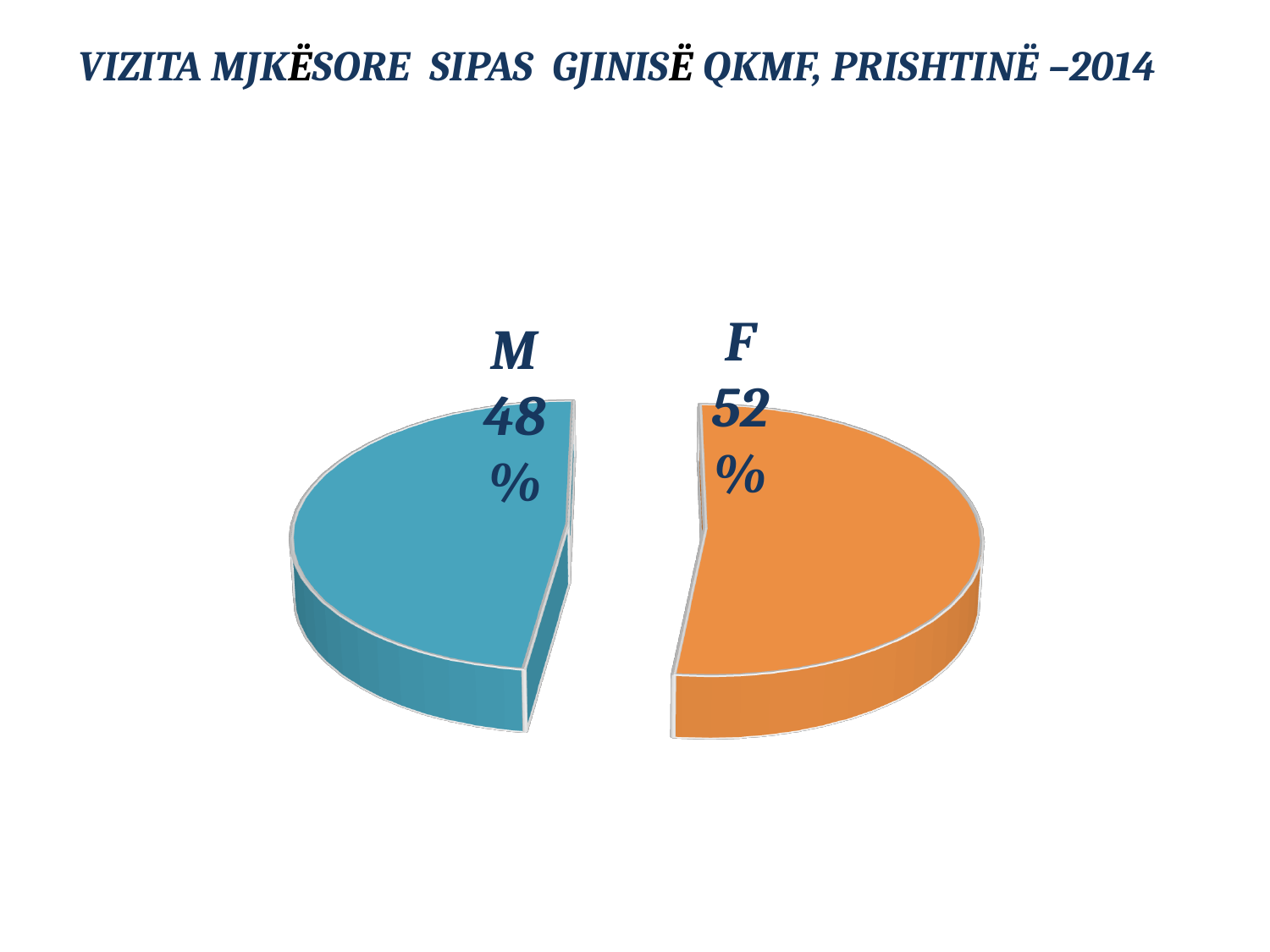
What is the difference in percentage points between the F and M slices? 4 Is the share for F greater or less than 50%? greater Which category has the larger share of the pie, M or F? F Which category has the largest slice in the pie chart? F What kind of chart is shown on the slide? pie chart What colour is the slice labelled F? orange What percentage of the pie chart is labelled M? 48% What percentage of the pie chart is labelled F? 52% What colour is the slice labelled M? blue Which category has the smallest slice in the pie chart? M How many slices does the pie chart have? 2